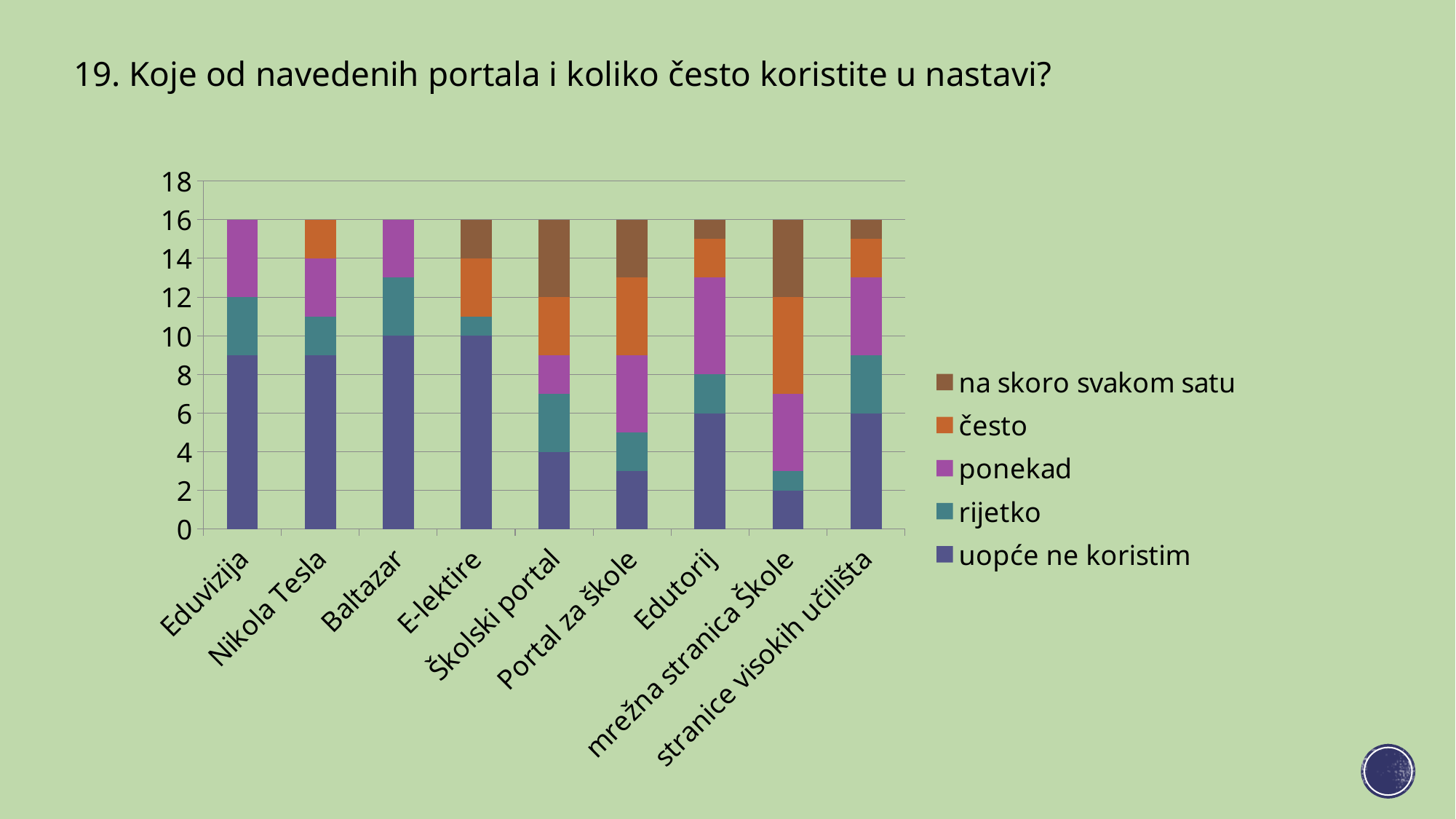
What is the value of 'uopće ne koristim' for Školski portal? 4 Is the value of 'uopće ne koristim' for Portal za škole greater or less than 4? less How many portals (categories) are shown on the x axis? 9 Is the value of 'uopće ne koristim' for Eduvizija greater or less than 8? greater What is the total height of the stacked bar for Eduvizija? 16 What is the value of 'uopće ne koristim' for Baltazar? 10 Which has a larger 'uopće ne koristim' value, Baltazar or Školski portal? Baltazar Which legend entry is shown in orange? često How many series does the legend list? 5 Which portal has the lowest value for 'uopće ne koristim'? mrežna stranica Škole What is the value of 'uopće ne koristim' for mrežna stranica Škole? 2 What kind of chart is shown on the slide? stacked bar chart